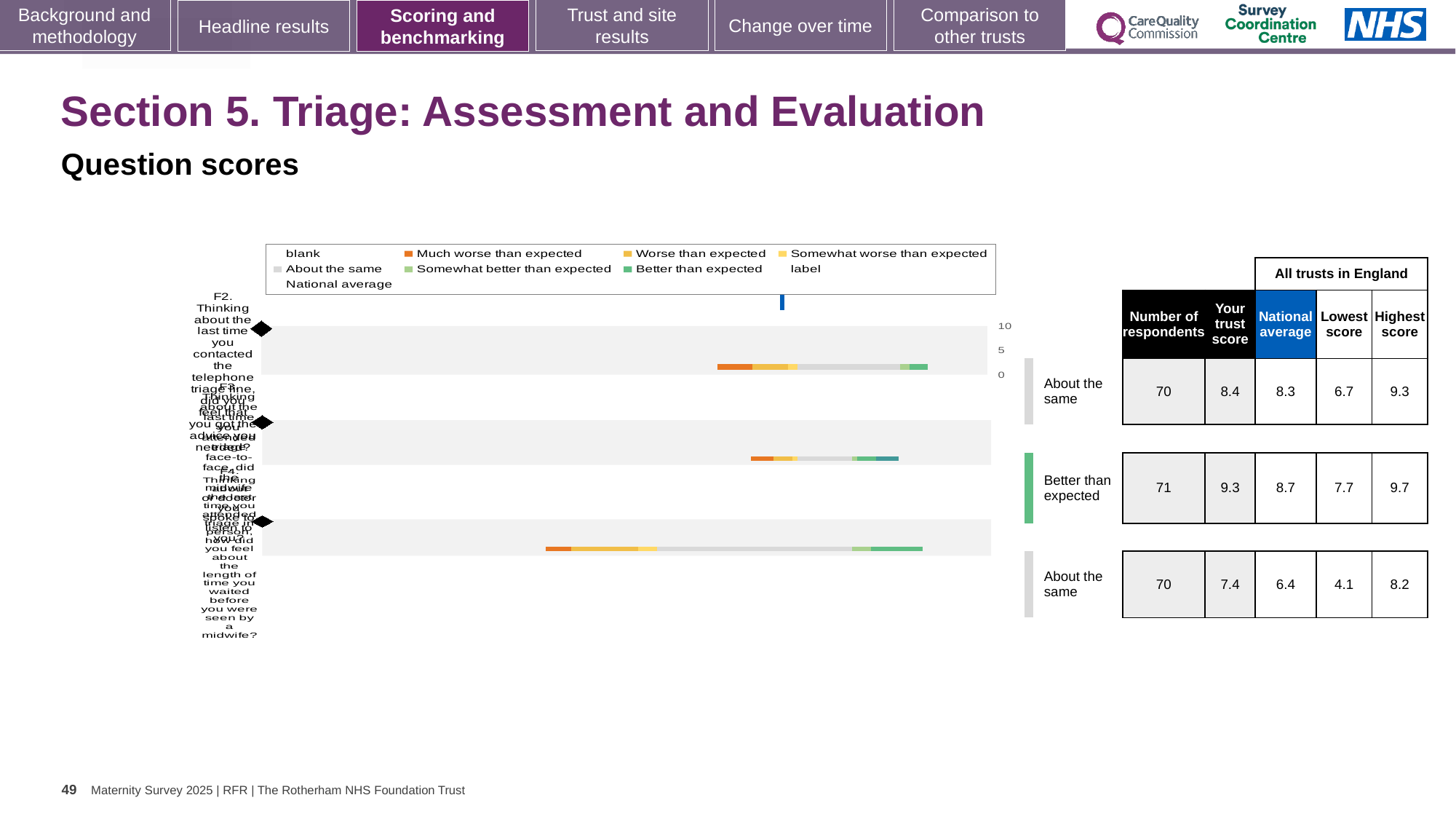
What is the highest score listed in the table for the second row? 9.7 Which row in the table has the lowest 'Your trust score'? third row (About the same, 7.4) What is the difference between the trust score and the national average in the third row of the table? 1.0 In the table next to the chart, what is the 'Your trust score' for the second row (Better than expected)? 9.3 In the table next to the chart, how many respondents are listed for the second row? 71 In the table next to the chart, what is the lowest score for the third row? 4.1 In the table next to the chart, what is the national average for the first row? 8.3 What kind of chart is shown on the slide? bar chart Which legend entry is shown with an orange colour? Much worse than expected Is the trust score in the first row of the table larger or smaller than the national average in that row? larger Which row in the table has the highest 'Your trust score'? Better than expected (second row) How many question rows (bars) does the chart show? 3